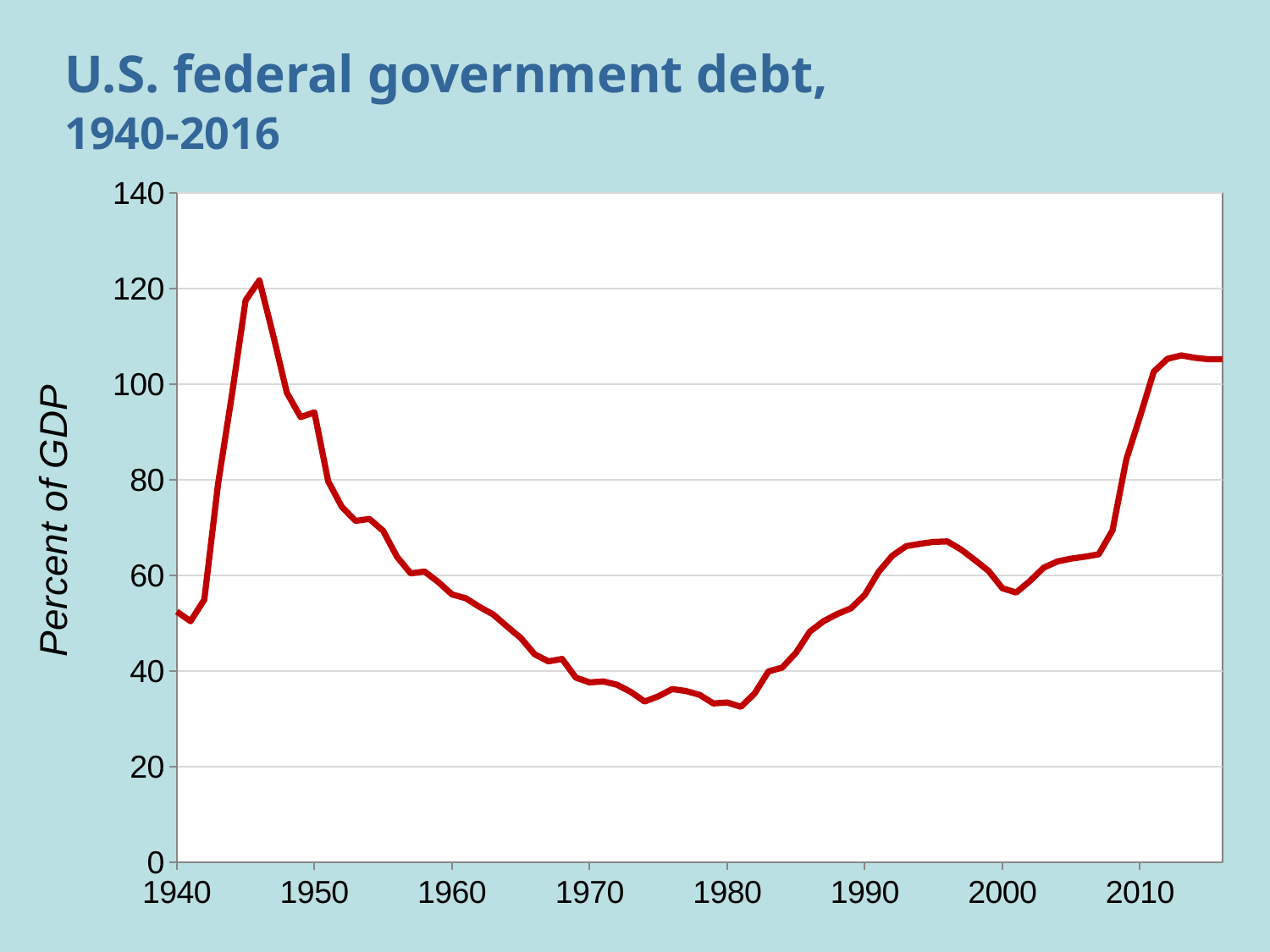
What is the label on the vertical axis? Percent of GDP What kind of chart is shown on the slide? line chart Does the line rise or fall between 1946 and 1981? fall What is the title of the chart? U.S. federal government debt, 1940-2016 In which year does the line reach its highest value? 1946 Does the line rise or fall between 2007 and 2012? rise Is the value for 1946 greater or less than 100? greater Which is larger, the value for 1950 or the value for 1990? 1950 Is the value for 1980 greater or less than 40? less Is the value for 2016 greater or less than 100? greater How many lines are plotted on the chart? 1